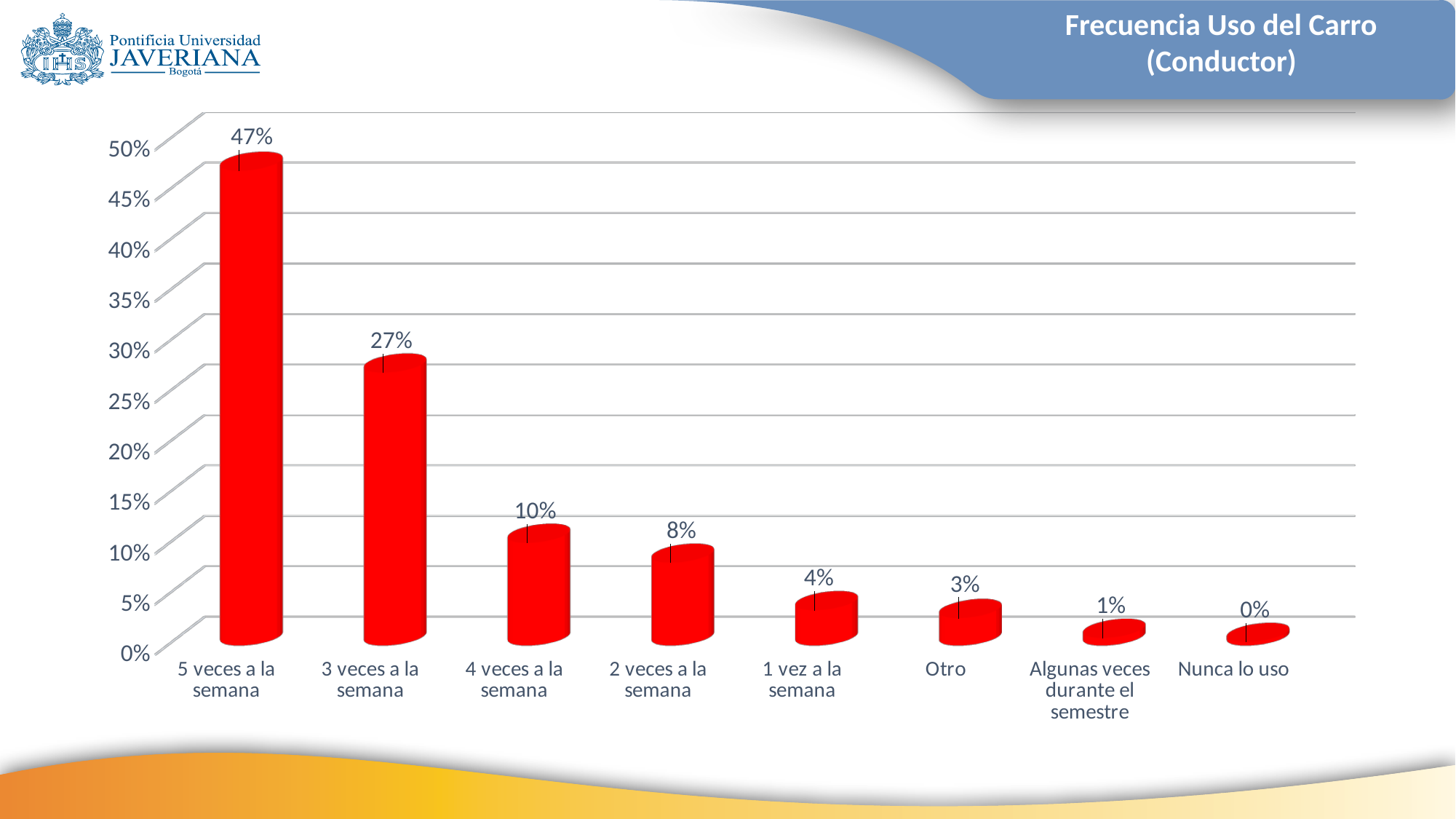
What is the difference between the values for "5 veces a la semana" and "3 veces a la semana"? 20% What is the value for "Algunas veces durante el semestre"? 1% How many categories are shown on the x axis? 8 What is the value for "5 veces a la semana"? 47% What is the value for "Otro"? 3% Which category has the highest value? 5 veces a la semana Which is larger, the value for "1 vez a la semana" or the value for "Otro"? 1 vez a la semana Which category has the lowest value? Nunca lo uso What is the title of the chart? Frecuencia Uso del Carro (Conductor) What is the value for "3 veces a la semana"? 27% What kind of chart is shown on the slide? Bar chart What is the difference between the values for "4 veces a la semana" and "2 veces a la semana"? 2%